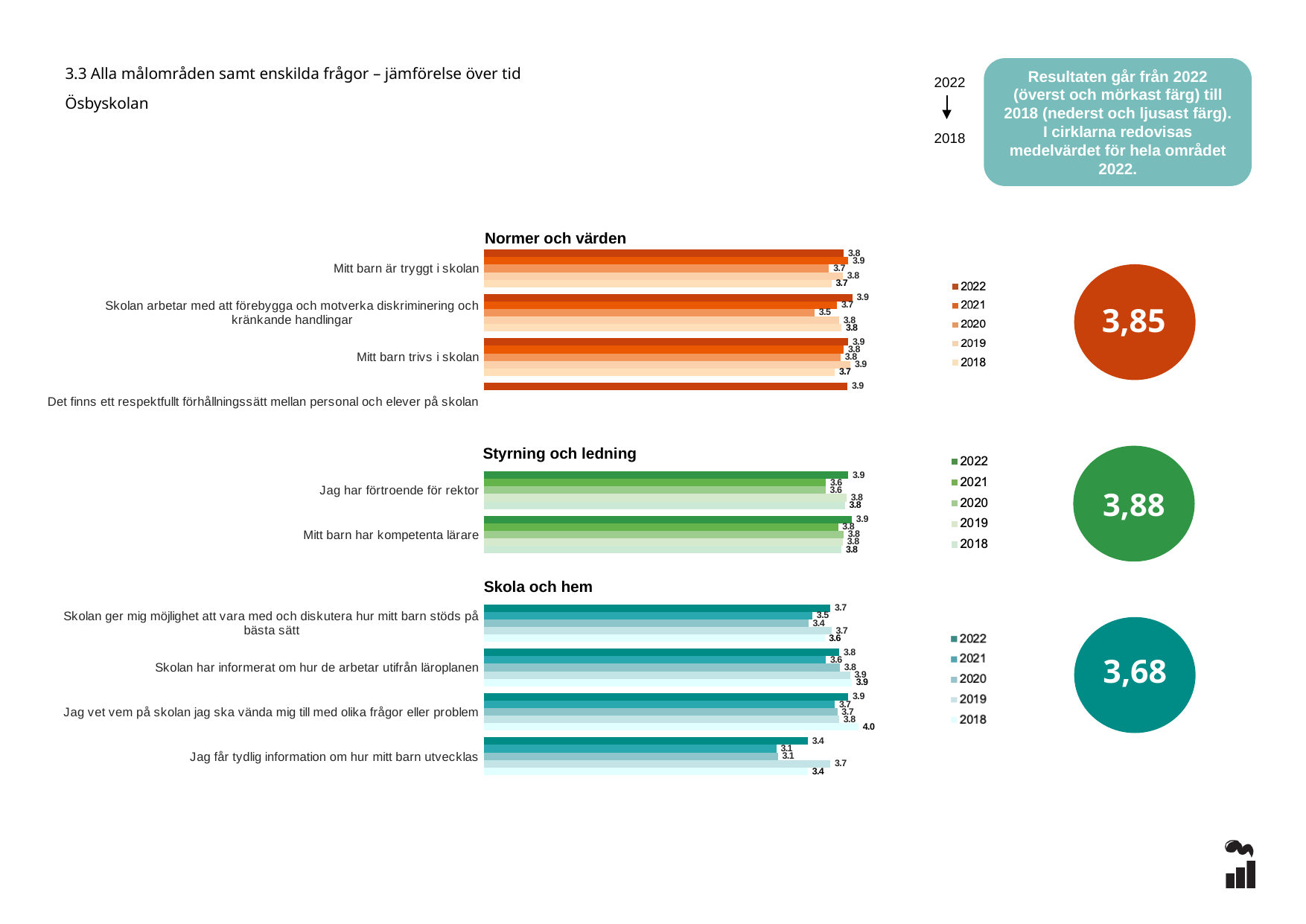
In the "Styrning och ledning" chart, which is larger for "Jag har förtroende för rektor": the 2022 value or the 2021 value? 2022 In the "Skola och hem" chart, what is the 2021 value for "Jag får tydlig information om hur mitt barn utvecklas"? 3.1 In the "Skola och hem" chart, what is the difference between the 2022 and 2021 values for "Jag får tydlig information om hur mitt barn utvecklas"? 0.3 In the "Skola och hem" chart, what is the 2018 value for "Jag vet vem på skolan jag ska vända mig till med olika frågor eller problem"? 4.0 How many series does the legend of the "Skola och hem" chart list? 5 How many questions (categories) are shown in the "Skola och hem" chart? 4 In the "Normer och värden" chart, what is the 2022 value for "Mitt barn är tryggt i skolan"? 3.8 In the "Skola och hem" chart, which year has the lowest value for "Skolan ger mig möjlighet att vara med och diskutera hur mitt barn stöds på bästa sätt"? 2020 In the "Styrning och ledning" chart, what is the 2022 value for "Jag har förtroende för rektor"? 3.9 What kind of chart is the "Normer och värden" chart? Bar chart What mean value for 2022 is shown in the circle next to the "Skola och hem" chart? 3,68 In the "Normer och värden" chart, what is the 2020 value for "Skolan arbetar med att förebygga och motverka diskriminering och kränkande handlingar"? 3.5